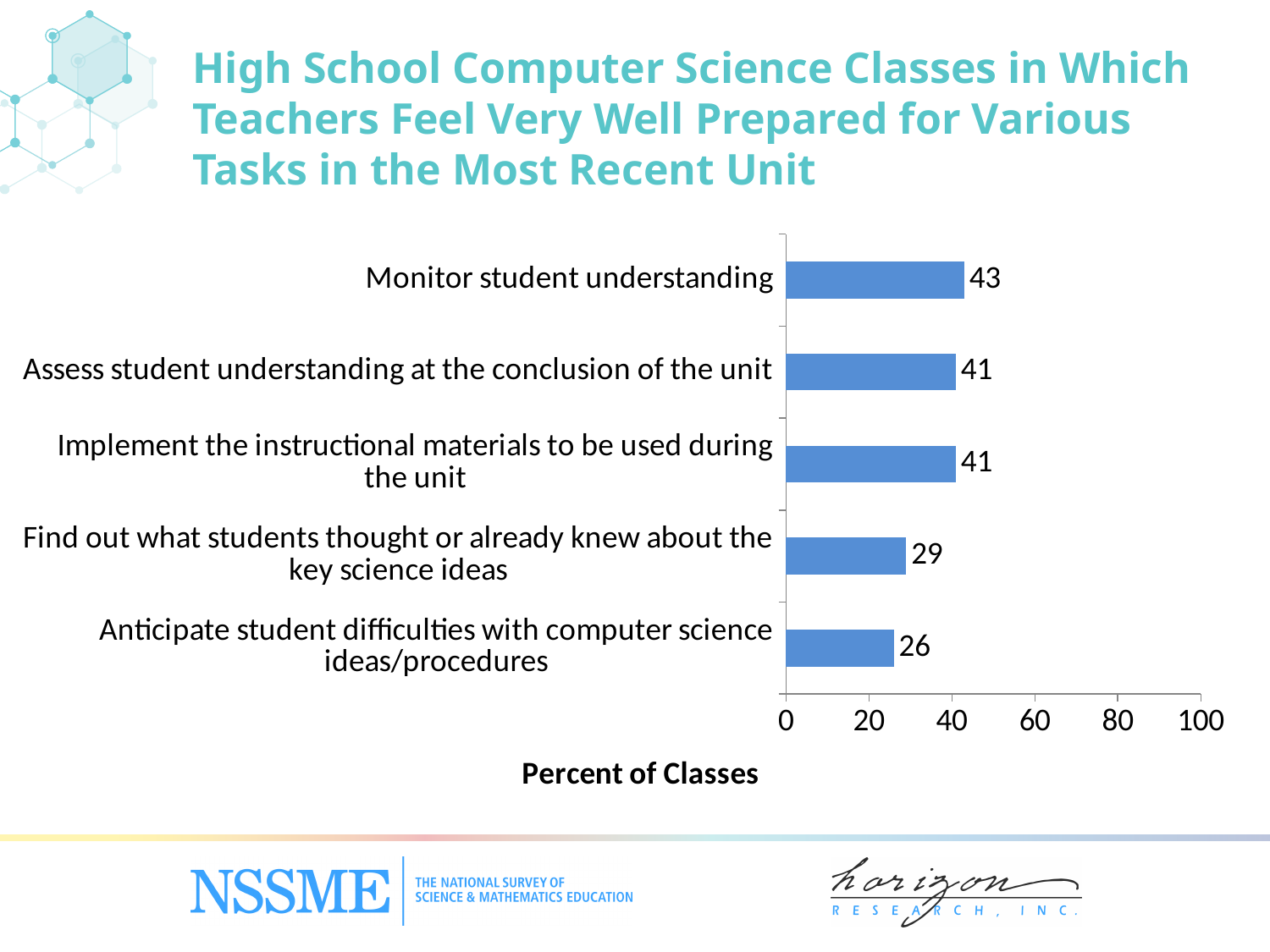
Which is larger: the value for 'Monitor student understanding' or the value for 'Find out what students thought or already knew about the key science ideas'? Monitor student understanding Which task has the highest percent of classes? Monitor student understanding What percent of classes have teachers who feel very well prepared to monitor student understanding? 43 Which task has the lowest percent of classes? Anticipate student difficulties with computer science ideas/procedures What is the label of the horizontal axis? Percent of Classes What is the difference between the values for 'Monitor student understanding' and 'Anticipate student difficulties with computer science ideas/procedures'? 17 What is the value for 'Anticipate student difficulties with computer science ideas/procedures'? 26 How many tasks are shown in the chart? 5 What is the difference between the values for 'Assess student understanding at the conclusion of the unit' and 'Find out what students thought or already knew about the key science ideas'? 12 Is the value for 'Implement the instructional materials to be used during the unit' greater or less than 60? less What is the value for 'Find out what students thought or already knew about the key science ideas'? 29 What kind of chart is shown on the slide? Bar chart